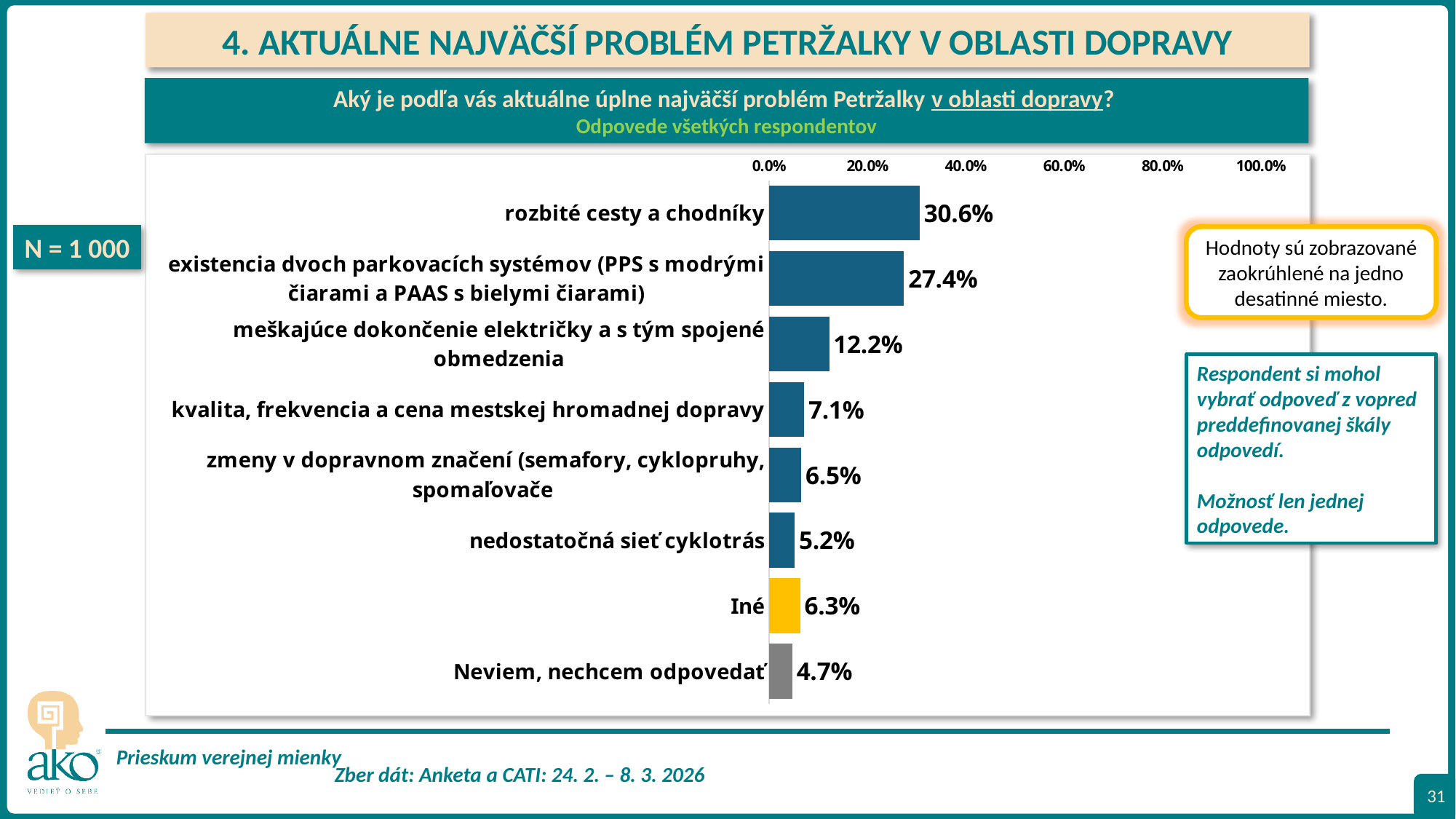
What is the difference in percentage points between 'meškajúce dokončenie električky a s tým spojené obmedzenia' and 'kvalita, frekvencia a cena mestskej hromadnej dopravy'? 5.1 percentage points Which category has the highest value in the chart? rozbité cesty a chodníky What percentage is shown for 'Iné'? 6.3% What is the difference in percentage points between 'rozbité cesty a chodníky' and 'existencia dvoch parkovacích systémov (PPS s modrými čiarami a PAAS s bielymi čiarami)'? 3.2 percentage points Which is larger: the value for 'zmeny v dopravnom značení (semafory, cyklopruhy, spomaľovače)' or the value for 'Iné'? zmeny v dopravnom značení (semafory, cyklopruhy, spomaľovače) Which category has the lowest value in the chart? Neviem, nechcem odpovedať What is the value shown for 'meškajúce dokončenie električky a s tým spojené obmedzenia'? 12.2% What kind of chart is shown on the slide? bar chart Is the value for 'rozbité cesty a chodníky' greater or less than 20.0%? greater What percentage of respondents named 'rozbité cesty a chodníky' as the biggest transport problem? 30.6% What value is shown for 'nedostatočná sieť cyklotrás'? 5.2% How many categories are shown in the chart? 8